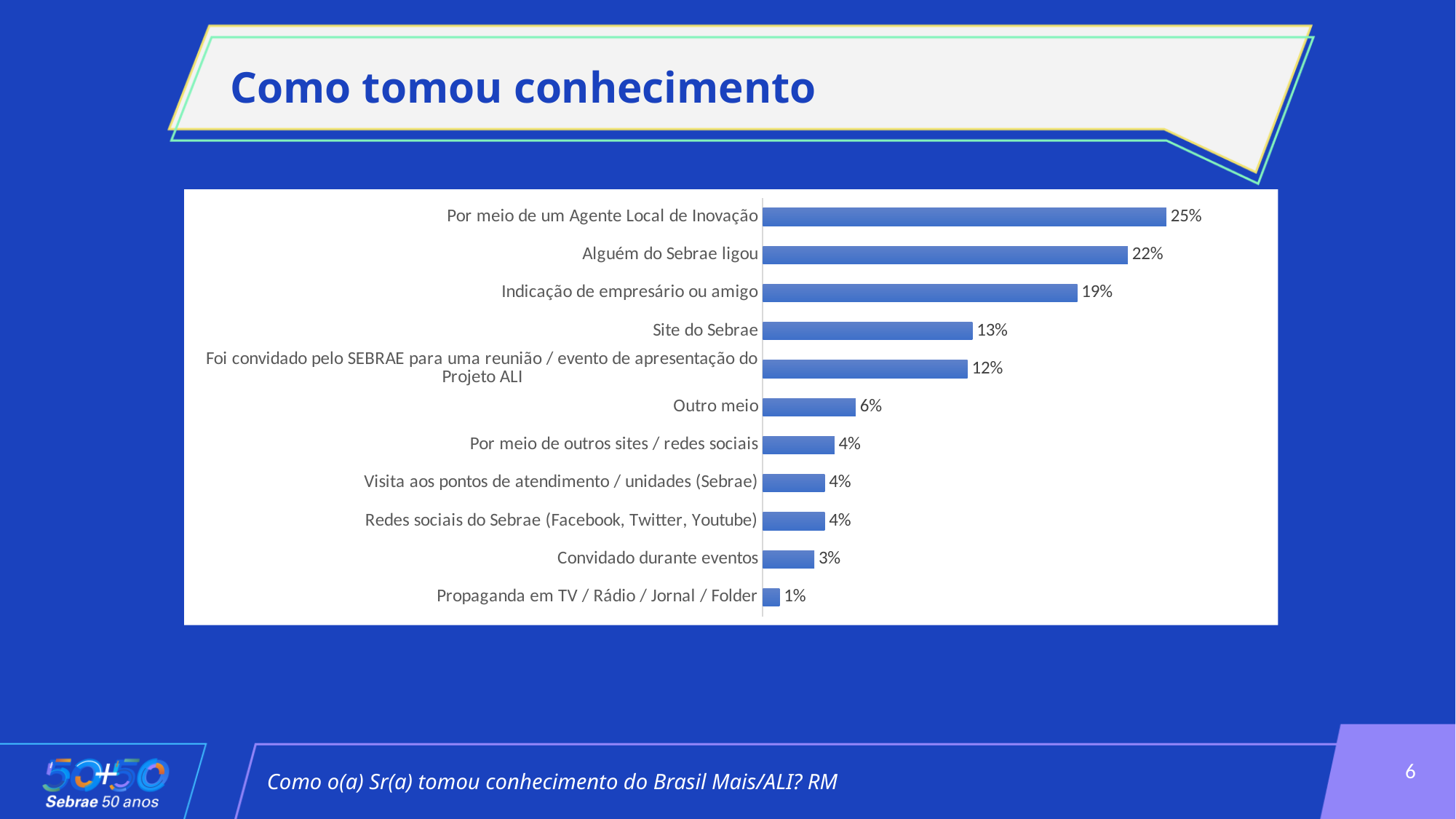
What is the value shown for 'Site do Sebrae'? 13% What is the value shown for 'Outro meio'? 6% What is the value for 'Propaganda em TV / Rádio / Jornal / Folder'? 1% Which is larger: the value for 'Site do Sebrae' or the value for 'Foi convidado pelo SEBRAE para uma reunião / evento de apresentação do Projeto ALI'? Site do Sebrae Which category has the highest value in the chart? Por meio de um Agente Local de Inovação How many categories are shown in the chart? 11 Which category has the lowest value in the chart? Propaganda em TV / Rádio / Jornal / Folder What is the title of the slide containing the chart? Como tomou conhecimento What is the difference between 'Por meio de um Agente Local de Inovação' and 'Site do Sebrae'? 12% What percentage of respondents learned about the program 'Por meio de um Agente Local de Inovação'? 25% What kind of chart is shown on the slide? Bar chart What is the difference between the values for 'Alguém do Sebrae ligou' and 'Indicação de empresário ou amigo'? 3%